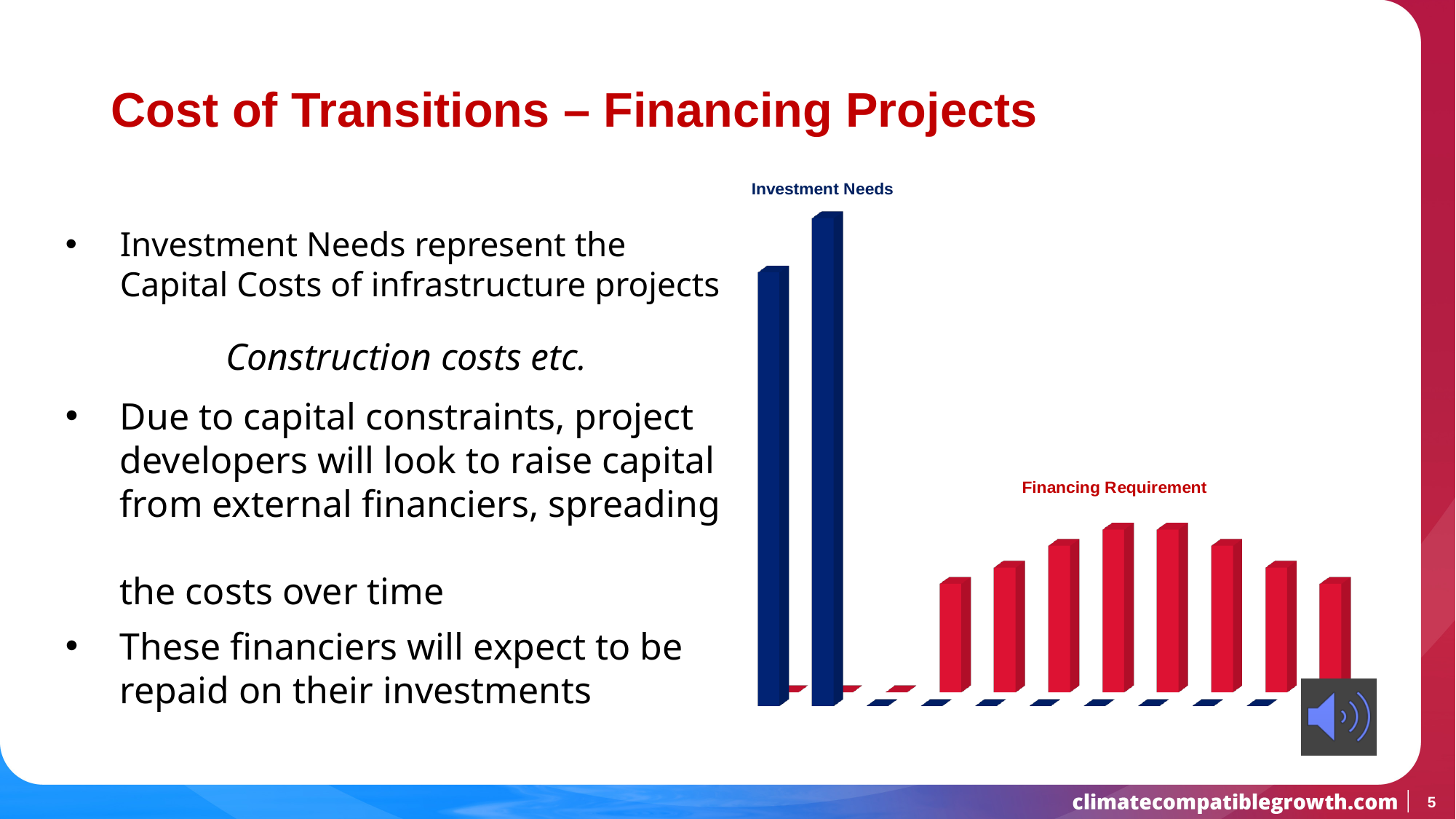
How many Investment Needs bars are shown in the chart? 2 How do the Financing Requirement bars change from left to right? they rise and then fall What colour are the Investment Needs bars? dark blue How many Financing Requirement bars are shown in the chart? 8 Do the Investment Needs bars rise or fall from left to right? rise How many series are shown in the chart? 2 Which series appears further to the right along the x axis, Investment Needs or Financing Requirement? Financing Requirement What kind of chart is shown on the slide? bar chart Are the Investment Needs bars taller or shorter than the Financing Requirement bars? taller What are the names of the two series shown in the chart? Investment Needs and Financing Requirement Which of the two Investment Needs bars is taller, the first or the second? the second